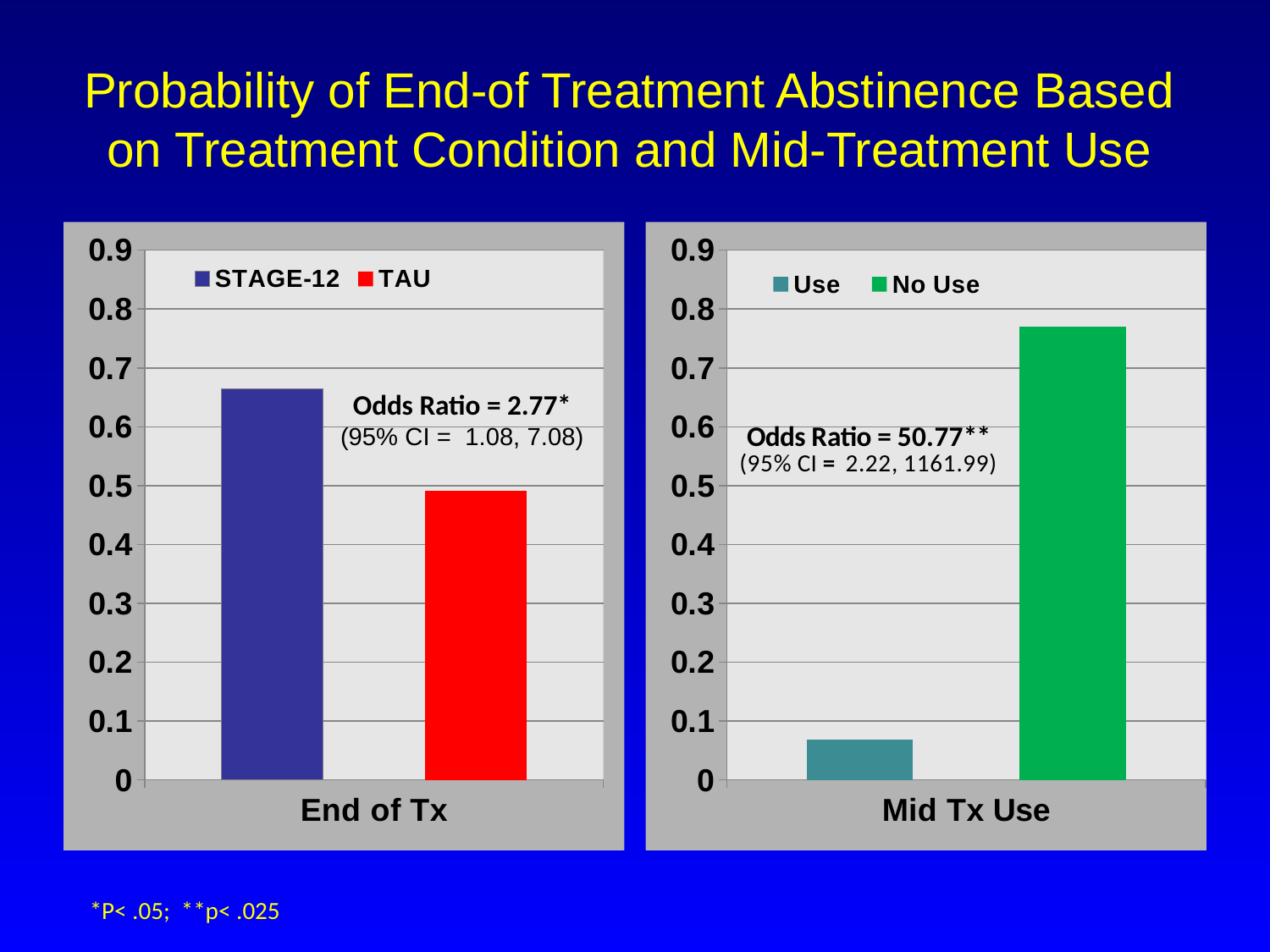
In the left chart (End of Tx), which series has the taller bar, STAGE-12 or TAU? STAGE-12 In the left chart (End of Tx), what kind of chart is shown? bar chart In the left chart (End of Tx), how many series does the legend list? 2 In the left chart (End of Tx), is the value for TAU greater or less than 0.6? less In the right chart (Mid Tx Use), is the value for No Use greater or less than 0.7? greater In the left chart (End of Tx), is the value for STAGE-12 greater or less than 0.6? greater In the right chart (Mid Tx Use), what kind of chart is shown? bar chart In the right chart (Mid Tx Use), which series has the highest bar? No Use In the left chart (End of Tx), what odds ratio is printed on the chart? 2.77 In the right chart (Mid Tx Use), how many series does the legend list? 2 In the right chart (Mid Tx Use), which series has the lowest bar? Use